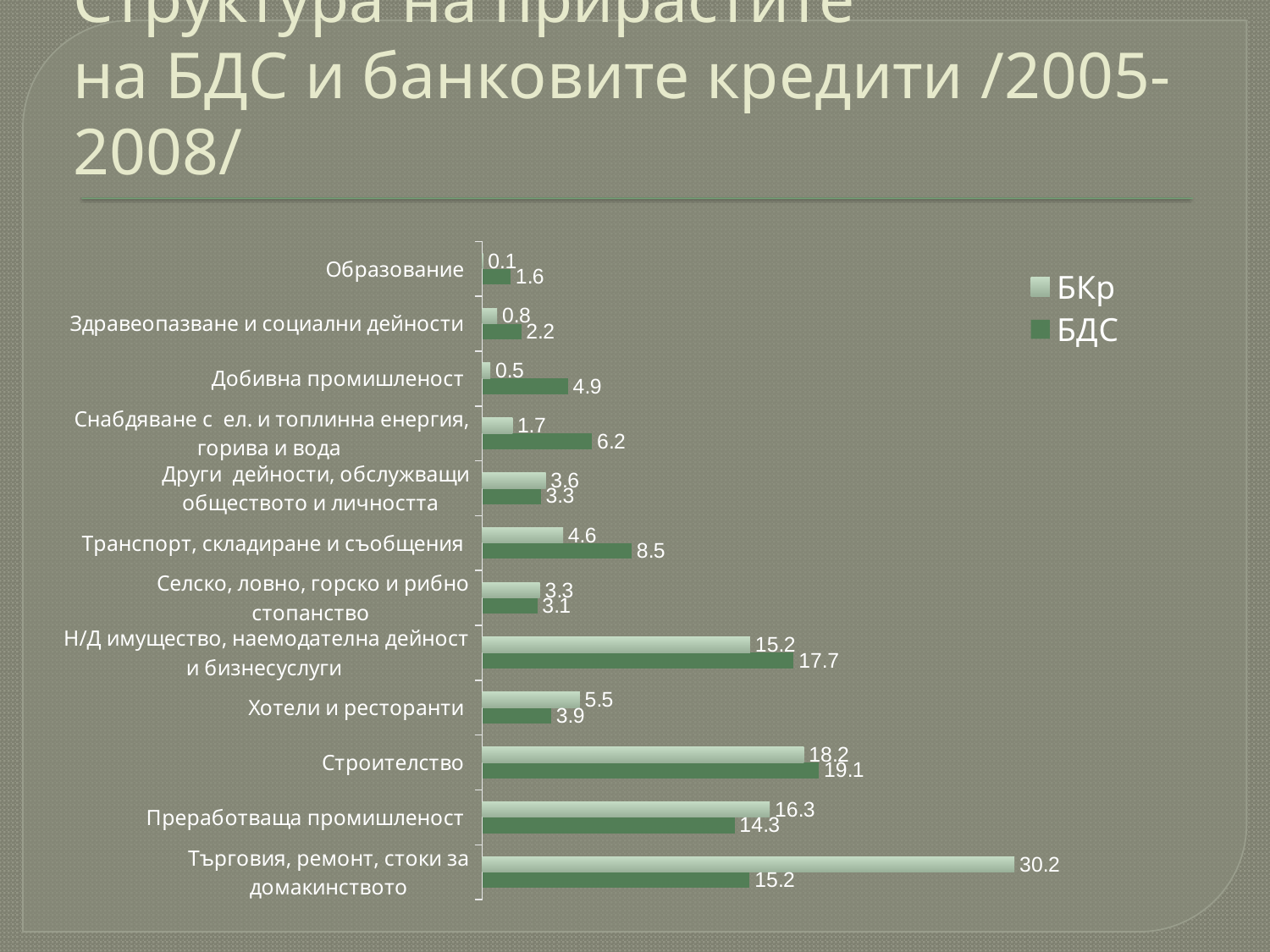
Which category has the highest БКр value? Търговия, ремонт, стоки за домакинството How many series does the legend list? 2 What kind of chart is shown on the slide? Bar chart Which is larger for Хотели и ресторанти, the БКр value or the БДС value? БКр What is the БКр value for Строителство? 18.2 What is the difference between the БКр and БДС values for Търговия, ремонт, стоки за домакинството? 15.0 Which category has the lowest БКр value? Образование Which category has the highest БДС value? Строителство What is the БДС value for Добивна промишленост? 4.9 How many categories are shown in the chart? 12 What are the two series named in the legend? БКр and БДС What is the БДС value for Транспорт, складиране и съобщения? 8.5